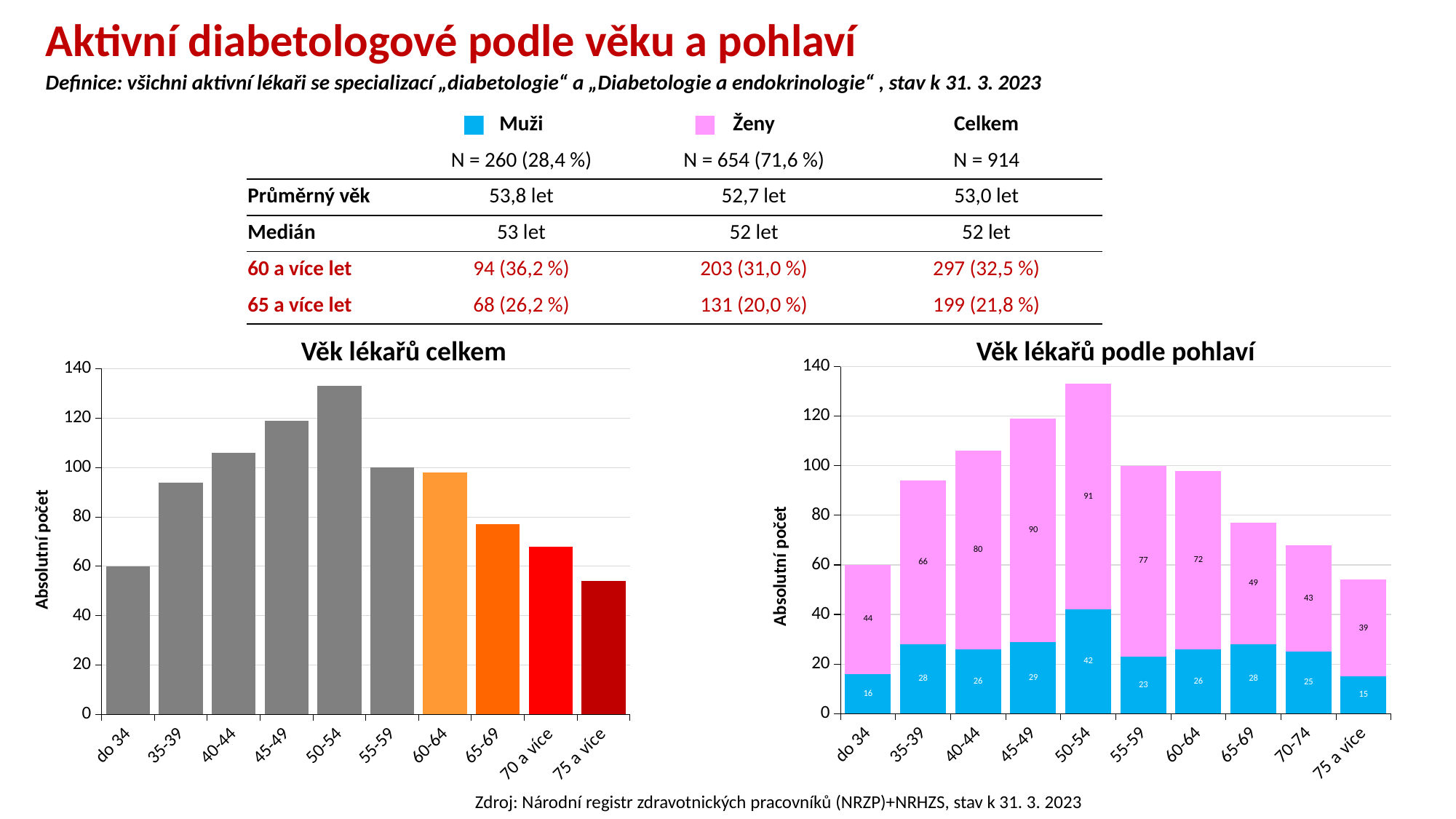
In the chart 'Věk lékařů celkem', do the values rise or fall from the 50-54 age group to the 75 a více age group? fall In the chart 'Věk lékařů podle pohlaví', what is the value for Muži in the 50-54 age group? 42 In the chart 'Věk lékařů podle pohlaví', which age group has the highest value for Ženy? 50-54 In the chart 'Věk lékařů podle pohlaví', is the value for Muži larger in the 65-69 group or in the 70-74 group? 65-69 How many age groups are shown on the x axis of the chart 'Věk lékařů celkem'? 10 In the chart 'Věk lékařů podle pohlaví', what is the difference between Ženy and Muži in the 40-44 age group? 54 In the chart 'Věk lékařů celkem', is the value for the 45-49 age group greater or less than 100? greater In the chart 'Věk lékařů podle pohlaví', which age group has the lowest value for Muži? 75 a více In the chart 'Věk lékařů podle pohlaví', what is the total of the stacked bar for the 35-39 age group? 94 What kind of chart is 'Věk lékařů celkem'? bar chart How many series does the legend list for the chart 'Věk lékařů podle pohlaví'? 2 In the chart 'Věk lékařů podle pohlaví', what is the value for Ženy in the 45-49 age group? 90